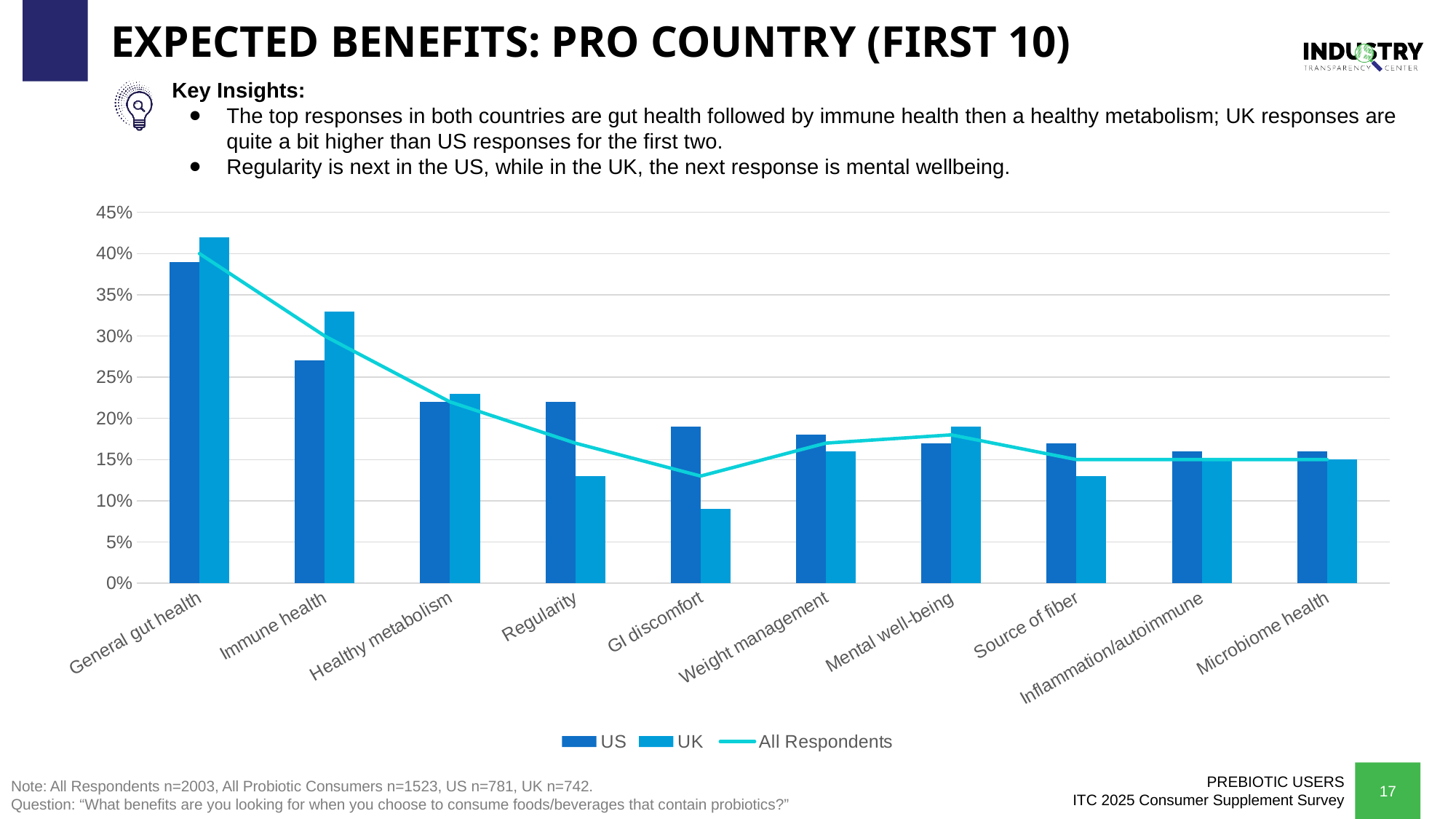
Which category has the highest UK value? General gut health Which category has the highest US value? General gut health How many benefit categories are shown on the x axis? 10 For Regularity, which is larger, the US value or the UK value? US Which series is plotted as a line rather than bars? All Respondents Is the UK value for General gut health greater or less than 40%? greater Does the All Respondents line rise or fall from General gut health to GI discomfort? fall What kind of chart is shown on the slide? bar chart with a line For Immune health, which is larger, the US value or the UK value? UK Is the UK value for GI discomfort greater or less than 10%? less How many series does the legend list? 3 Which category has the lowest UK value? GI discomfort